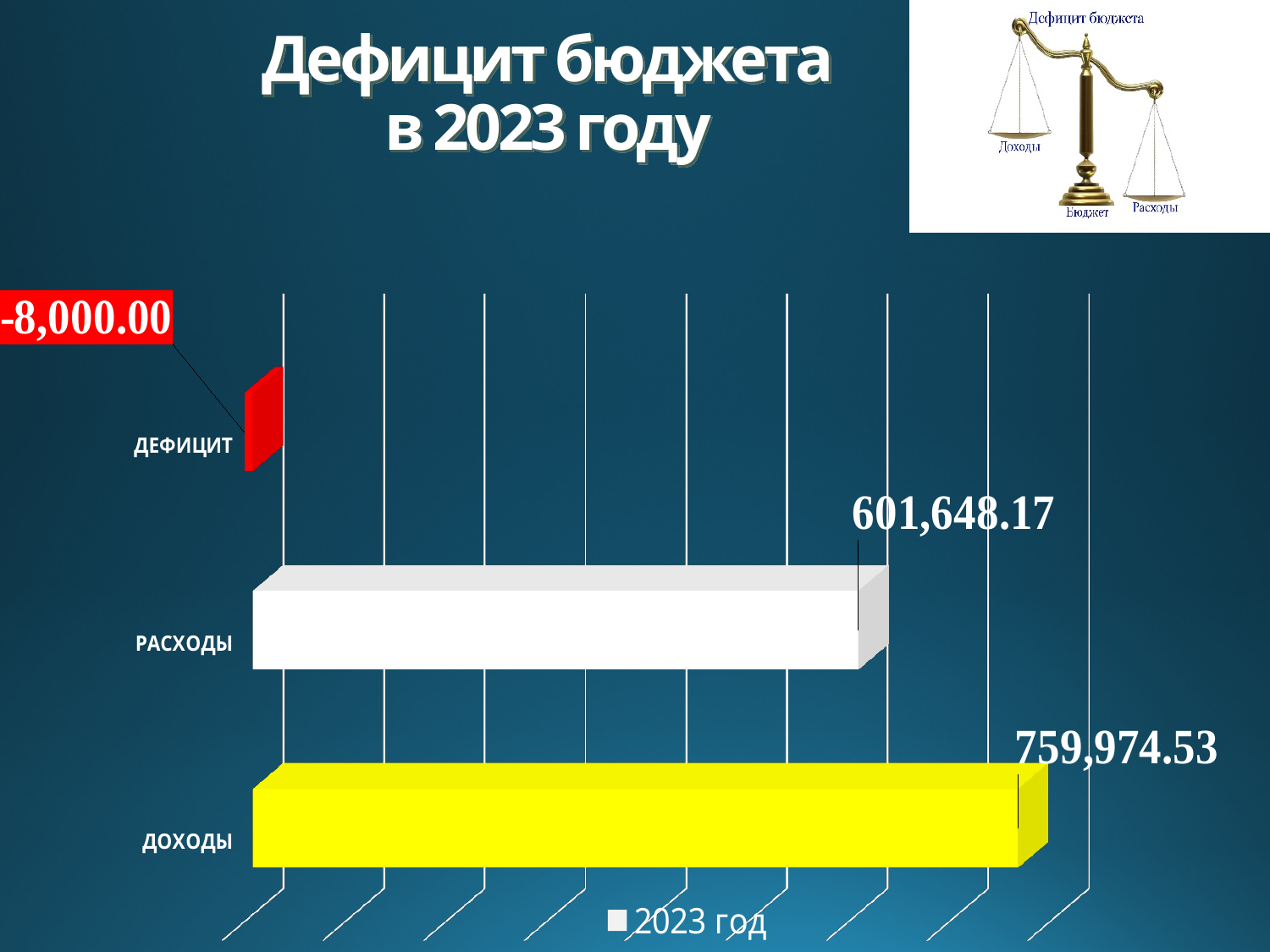
What kind of chart is shown on the slide? Bar chart What colour is the bar for ДОХОДЫ? Yellow What is the difference between the values for ДОХОДЫ and РАСХОДЫ? 158,326.36 What is the value for ДЕФИЦИТ? -8,000.00 Which category has the lowest value? ДЕФИЦИТ Which category has the highest value? ДОХОДЫ What is the value for ДОХОДЫ? 759,974.53 How many categories are shown in the chart? 3 What series name is shown in the chart legend? 2023 год How many series does the legend list? 1 Which is larger, the value for ДОХОДЫ or the value for РАСХОДЫ? ДОХОДЫ What is the value for РАСХОДЫ? 601,648.17